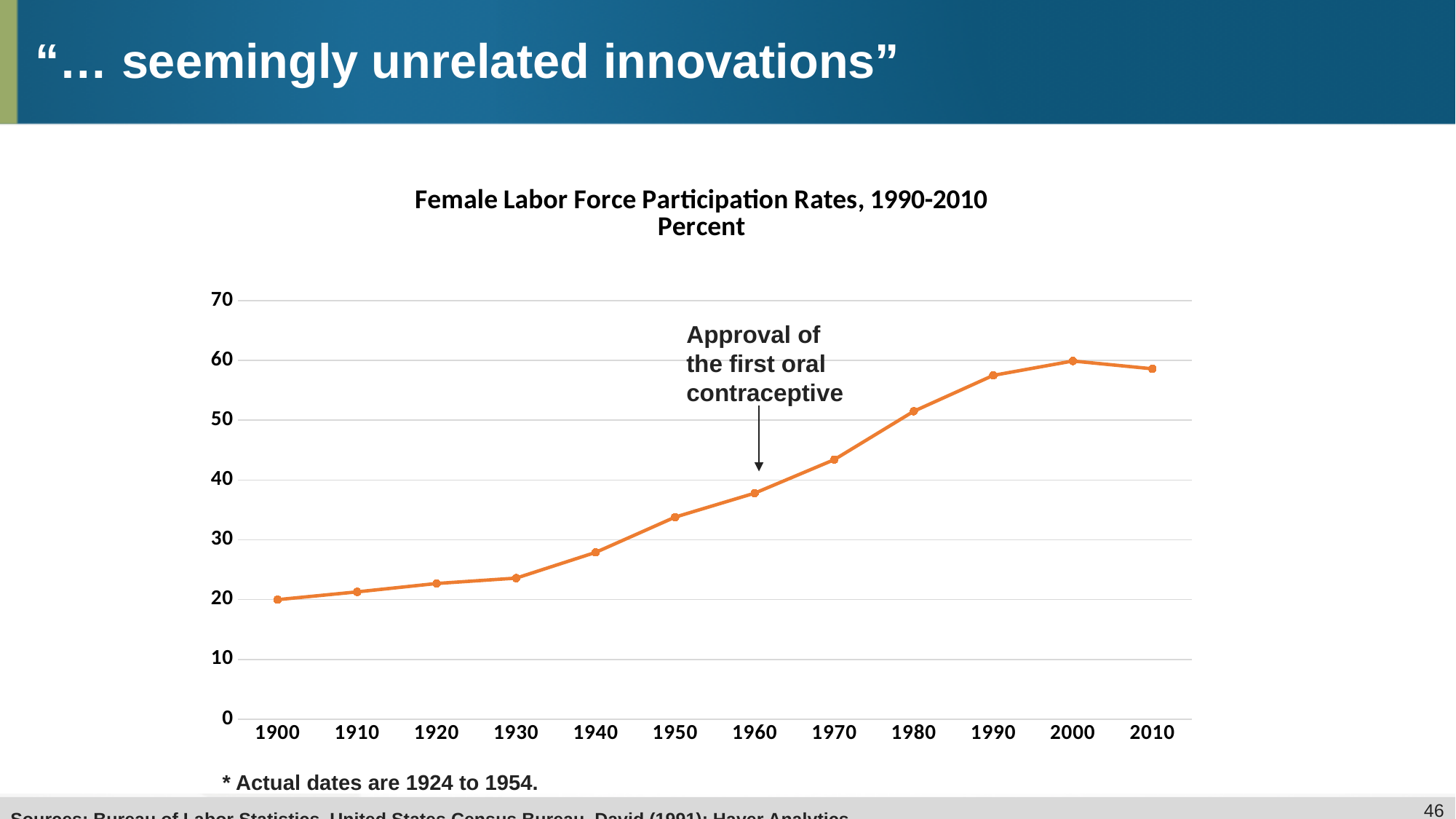
Is the value for 1970 greater or less than 40? greater What event does the arrow annotation on the chart mark at 1960? Approval of the first oral contraceptive Does the participation rate generally rise or fall from 1900 to 2000? rise What kind of chart is shown on the slide? line chart Is the value for 1940 greater or less than 30? less Which year has a higher participation rate, 1970 or 1990? 1990 Which year has the lowest female labor force participation rate? 1900 Is the value for 1980 greater or less than 50? greater Which year has the highest female labor force participation rate? 2000 What is the title of the chart? Female Labor Force Participation Rates, 1990-2010 How many data points are plotted on the line? 12